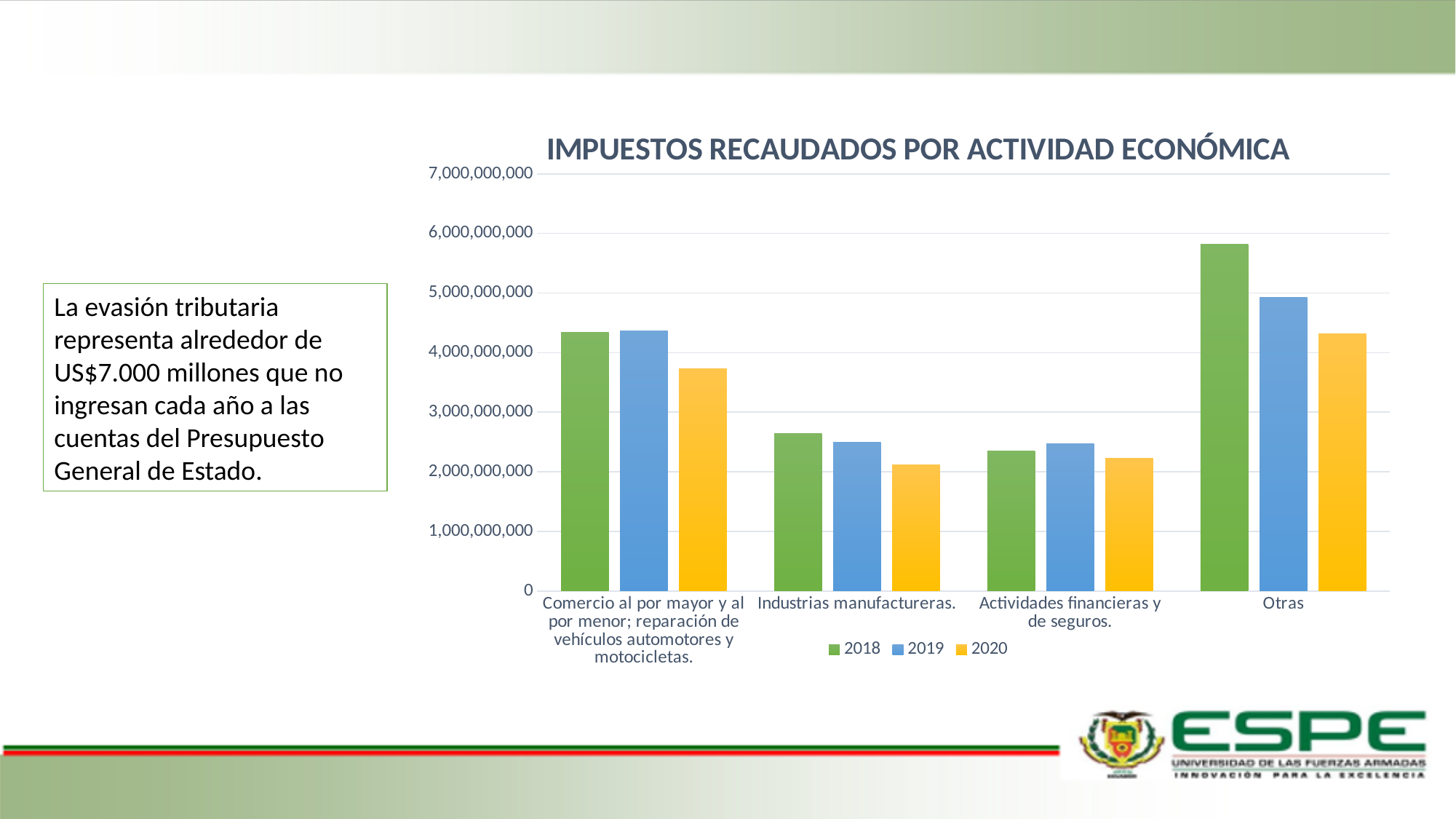
What is the title of the chart? IMPUESTOS RECAUDADOS POR ACTIVIDAD ECONÓMICA Which category has the highest value for 2018? Otras Is the 2018 value for Industrias manufactureras greater or less than 3,000,000,000? less Is the 2018 value for Otras greater or less than 5,000,000,000? greater How many series does the legend list? 3 For Otras, do the values rise or fall from 2018 to 2020? fall What kind of chart is shown on the slide? Bar chart Which category has the lowest value for 2020? Industrias manufactureras. Is the 2020 value for Comercio al por mayor y al por menor; reparación de vehículos automotores y motocicletas greater or less than 4,000,000,000? less For Otras, which year has the larger value, 2018 or 2019? 2018 For 2020, which is larger: Otras or Comercio al por mayor y al por menor? Otras How many economic activity categories are shown on the x axis? 4